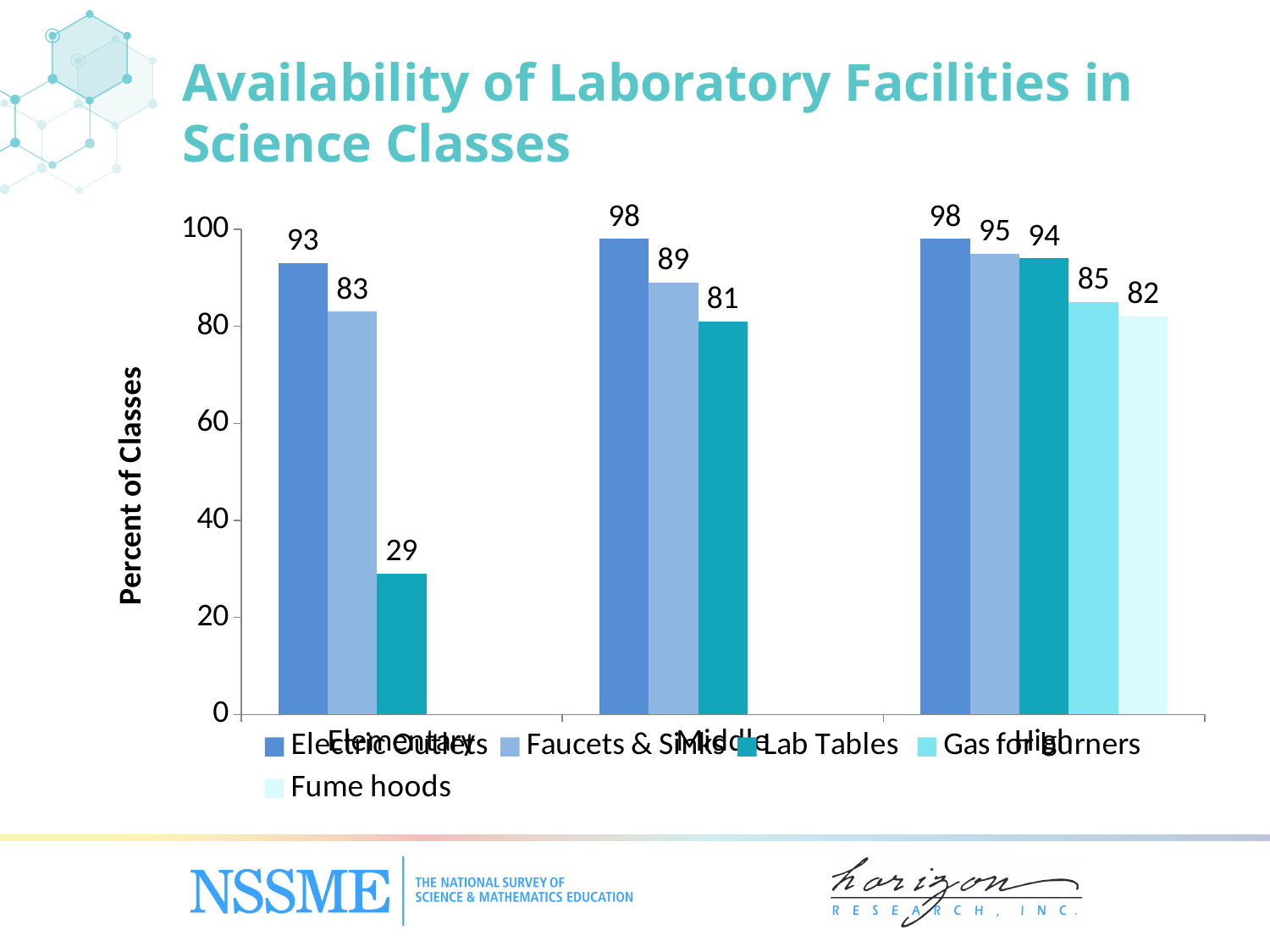
What is the value for Electric Outlets in Elementary classes? 93 Which facility has the highest value in High classes? Electric Outlets Which facility has the lowest value in Elementary classes? Lab Tables Which is larger: the Lab Tables value for Middle classes or the Lab Tables value for High classes? High What is the value for Lab Tables in Elementary classes? 29 What is the value for Fume hoods in High classes? 82 What is the difference between the Electric Outlets value and the Lab Tables value in Elementary classes? 64 What is the label on the vertical axis? Percent of Classes What is the value for Faucets & Sinks in Middle classes? 89 What is the value for Gas for Burners in High classes? 85 How many series does the legend list? 5 What kind of chart is shown on the slide? bar chart